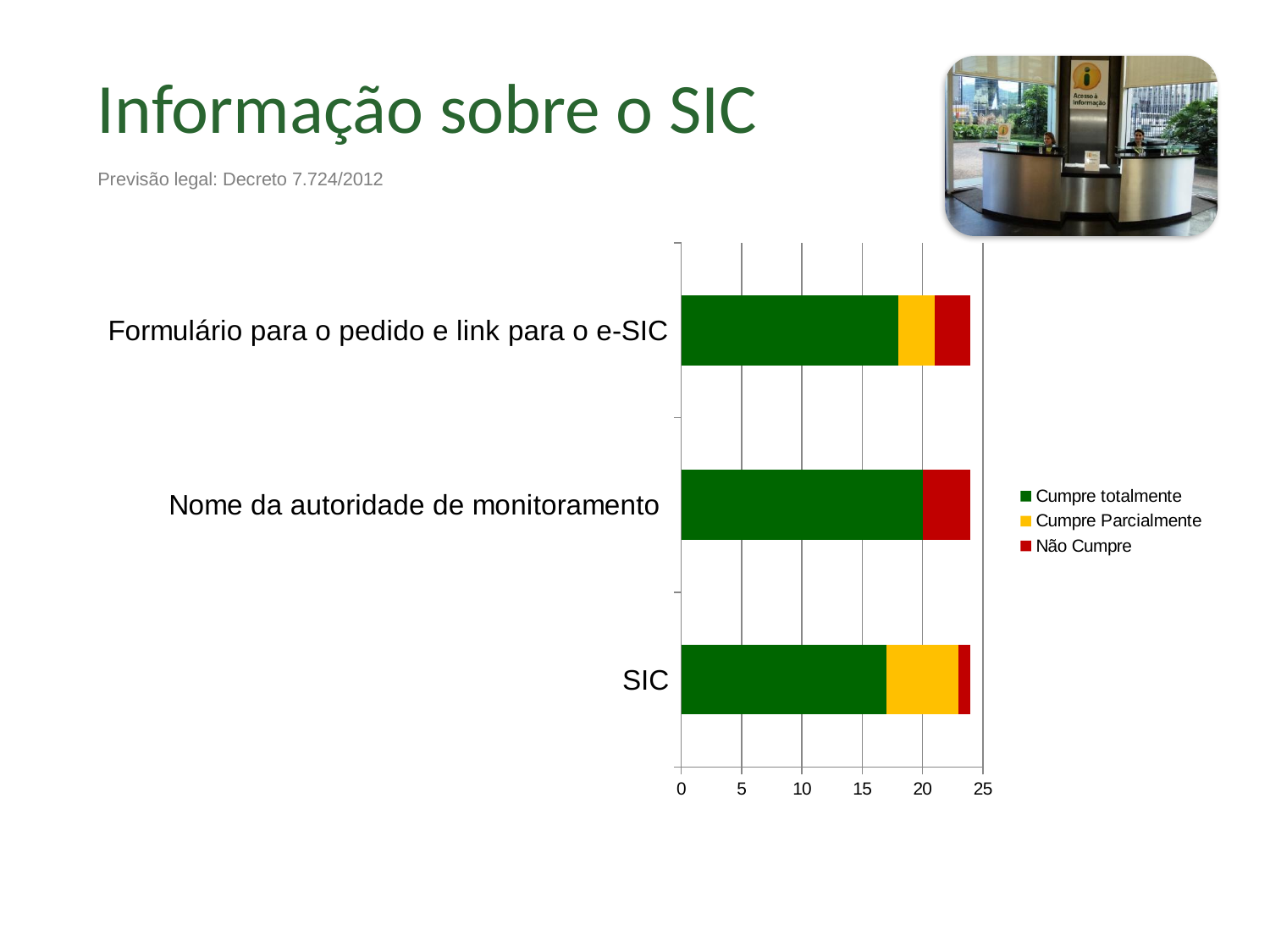
How many categories are plotted on the chart? 3 Is the 'Cumpre totalmente' value for 'Formulário para o pedido e link para o e-SIC' greater or less than 15? greater What colour represents 'Não Cumpre' in the chart legend? red How many series does the chart legend list? 3 Which category has the largest 'Cumpre Parcialmente' segment? SIC Which category has the largest 'Cumpre totalmente' segment? Nome da autoridade de monitoramento Is the 'Cumpre totalmente' value for 'SIC' greater or less than 20? less What kind of chart is shown on the slide? bar chart Is the 'Cumpre totalmente' value for 'Nome da autoridade de monitoramento' greater or less than 15? greater Which category has no 'Cumpre Parcialmente' segment? Nome da autoridade de monitoramento Which category has the smallest 'Cumpre totalmente' segment? SIC Which has the larger 'Cumpre totalmente' value: 'Nome da autoridade de monitoramento' or 'SIC'? Nome da autoridade de monitoramento